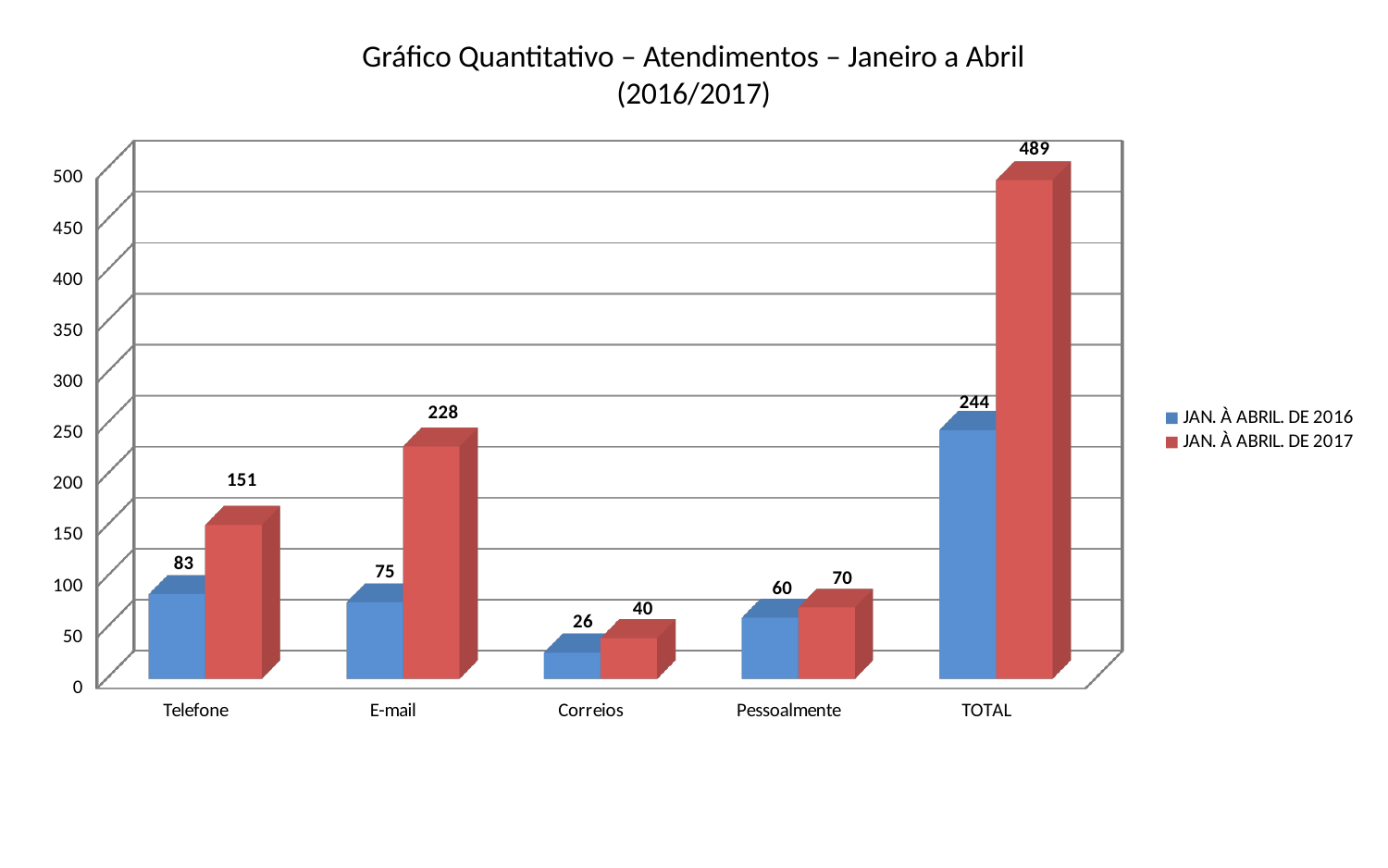
How many series does the legend list? 2 What is the value for Telefone in the JAN. À ABRIL. DE 2016 series? 83 Excluding TOTAL, which category has the highest value in the JAN. À ABRIL. DE 2017 series? E-mail What is the value for Correios in the JAN. À ABRIL. DE 2017 series? 40 Which is larger for Pessoalmente: the JAN. À ABRIL. DE 2016 value or the JAN. À ABRIL. DE 2017 value? JAN. À ABRIL. DE 2017 Which category has the lowest value in the JAN. À ABRIL. DE 2016 series? Correios What kind of chart is shown on the slide? Bar chart What is the title of the chart? Gráfico Quantitativo – Atendimentos – Janeiro a Abril (2016/2017) What is the difference between the 2017 and 2016 values for Telefone? 68 What is the value for E-mail in the JAN. À ABRIL. DE 2017 series? 228 What is the difference between the TOTAL values for JAN. À ABRIL. DE 2017 and JAN. À ABRIL. DE 2016? 245 How many categories are shown on the x axis? 5